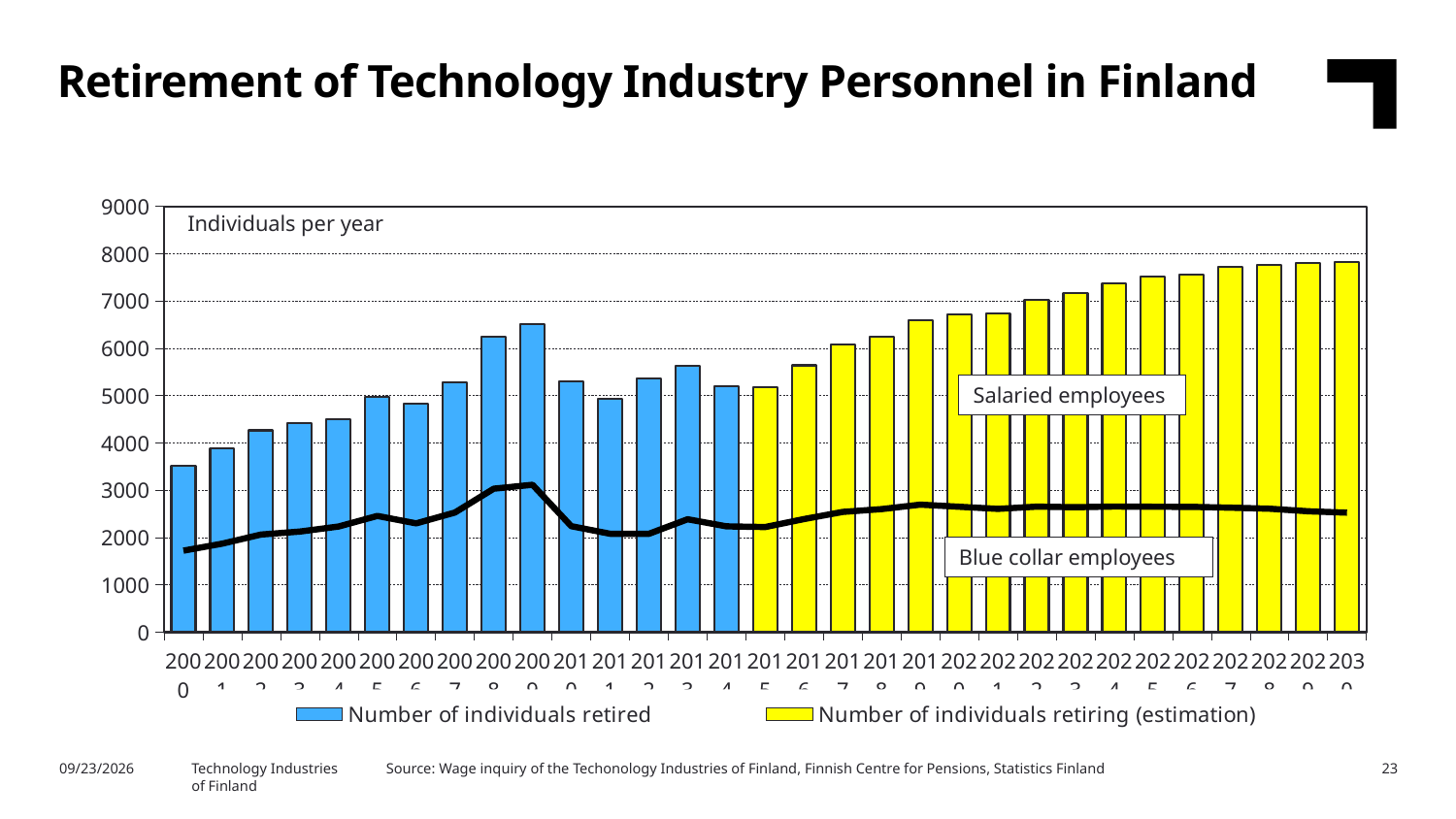
Which is larger, the value for 2009 or the value for 2010? 2009 Which year has the lowest number of individuals? 2000 Do the estimated values rise or fall from 2015 to 2030? rise Is the value for 2000 greater or less than 3000? greater What kind of chart is shown on the slide? combination bar and line chart How many series does the legend list? 2 Is the value for 2016 greater or less than 5000? greater What is the title of the chart on the slide? Retirement of Technology Industry Personnel in Finland How many years (bars) are shown along the x axis? 31 Is the value for 2009 greater or less than 6000? greater Which legend entry corresponds to the yellow bars? Number of individuals retiring (estimation)